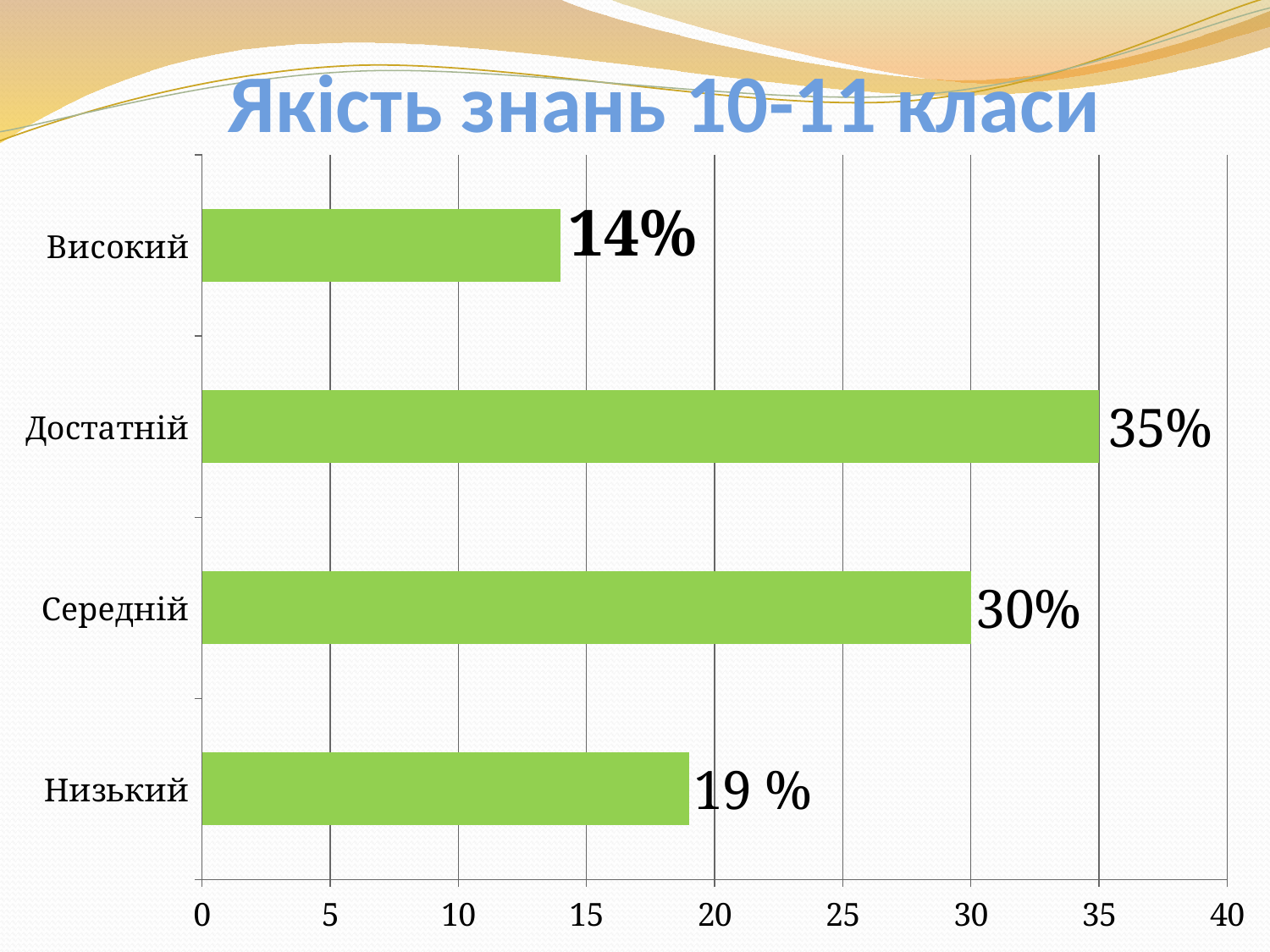
What is the value for Середній? 30% What is the difference between the values for Достатній and Середній? 5% What is the title of the chart? Якість знань 10-11 класи Which category has the highest value? Достатній How many categories are shown in the chart? 4 Which category has the lowest value? Високий What is the value for Низький? 19 % What is the value for Високий? 14% What is the difference between the values for Низький and Високий? 5% What is the value for Достатній? 35% Which is larger, the value for Середній or the value for Низький? Середній What kind of chart is shown on the slide? bar chart